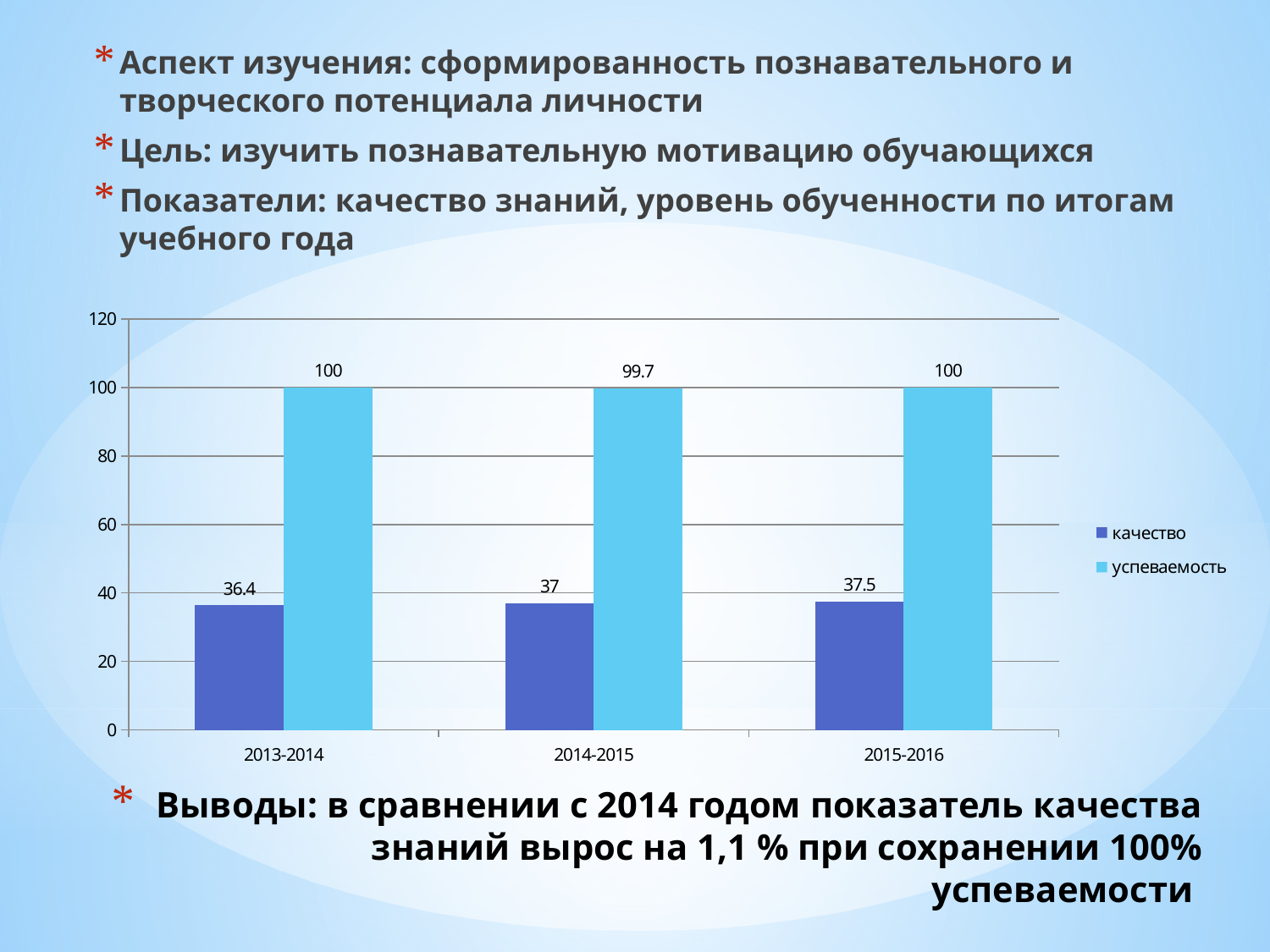
Which year has the lowest value for успеваемость? 2014-2015 What is the value of качество for 2015-2016? 37.5 What is the value of успеваемость for 2014-2015? 99.7 What kind of chart is shown on the slide? bar chart Which is larger: качество in 2014-2015 or качество in 2013-2014? 2014-2015 Which year has the highest value for качество? 2015-2016 How many years are shown on the x axis? 3 Does the value of качество rise or fall from 2013-2014 to 2015-2016? rise What is the difference between качество in 2015-2016 and 2013-2014? 1.1 Is the value of качество for 2014-2015 greater or less than 40? less How many series does the legend list? 2 What is the value of качество for 2013-2014? 36.4